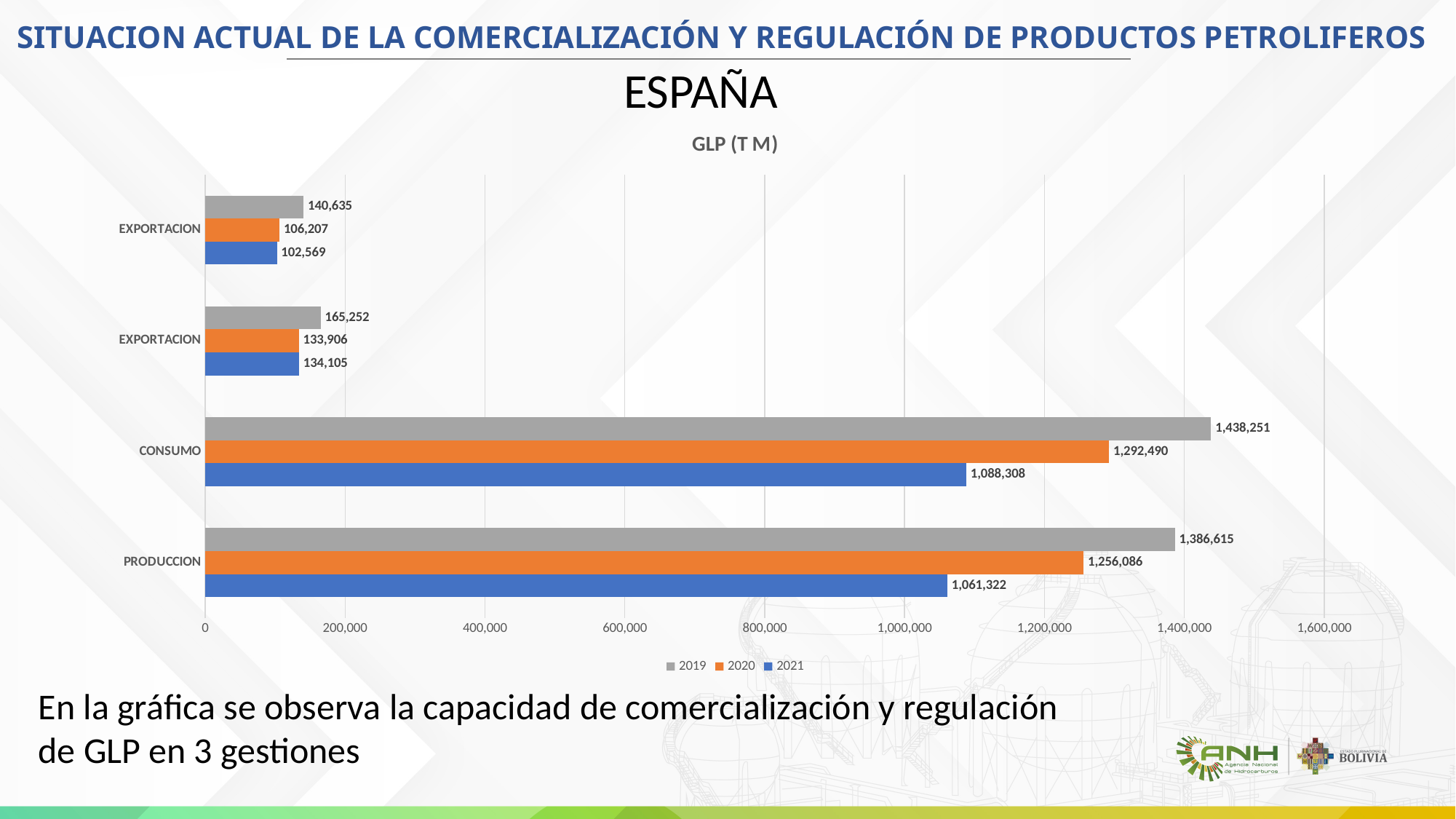
What is the value for CONSUMO in 2020? 1,292,490 What is the difference between the CONSUMO values for 2019 and 2021? 349,943 What is the value for PRODUCCION in 2021? 1,061,322 What is the value for CONSUMO in 2019? 1,438,251 What is the difference between the PRODUCCION values for 2019 and 2020? 130,529 How many categories are shown on the vertical axis? 4 Do the CONSUMO values rise or fall from 2019 to 2021? Fall What is the lowest value shown for the 2021 series? 102,569 Which is larger in 2020, CONSUMO or PRODUCCION? CONSUMO What kind of chart is shown? Bar chart Which category has the highest value for 2019? CONSUMO How many series does the legend list? 3